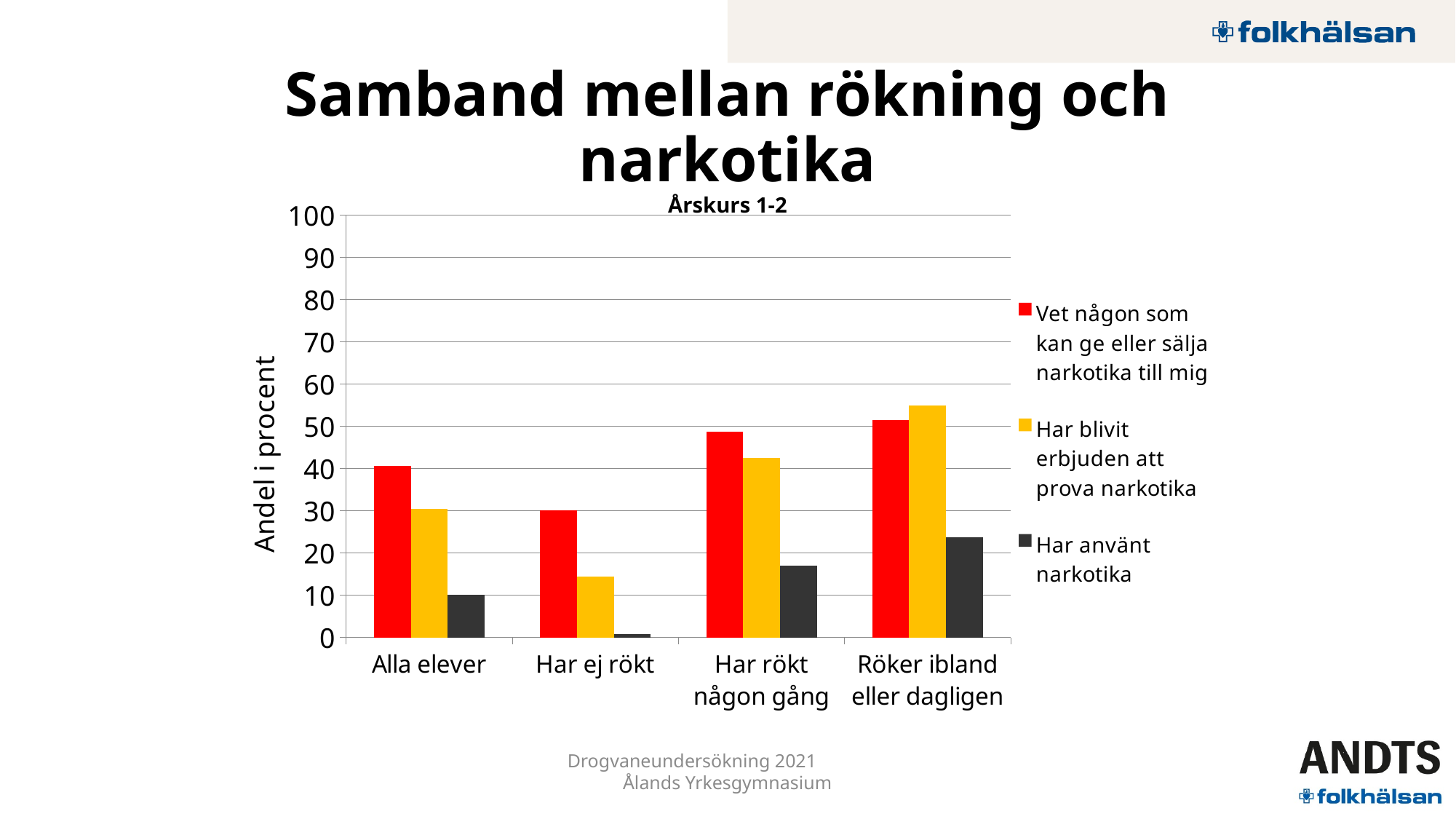
What is the label on the chart's y axis? Andel i procent In the 'Alla elever' category, which is larger: 'Vet någon som kan ge eller sälja narkotika till mig' or 'Har blivit erbjuden att prova narkotika'? Vet någon som kan ge eller sälja narkotika till mig How many series does the chart's legend list? 3 Which category has the lowest value for 'Har använt narkotika'? Har ej rökt Is the value for 'Har använt narkotika' in the 'Röker ibland eller dagligen' category greater or less than 20? greater Is the value for 'Vet någon som kan ge eller sälja narkotika till mig' in the 'Alla elever' category greater or less than 50? less What is the title printed above the chart? Årskurs 1-2 Does the value for 'Har använt narkotika' rise or fall going from 'Har ej rökt' to 'Har rökt någon gång' to 'Röker ibland eller dagligen'? rise Is the value for 'Har blivit erbjuden att prova narkotika' in the 'Har ej rökt' category greater or less than 20? less Which category has the highest value for 'Har använt narkotika'? Röker ibland eller dagligen How many categories are shown on the x axis of the chart? 4 What kind of chart is shown on the slide? bar chart